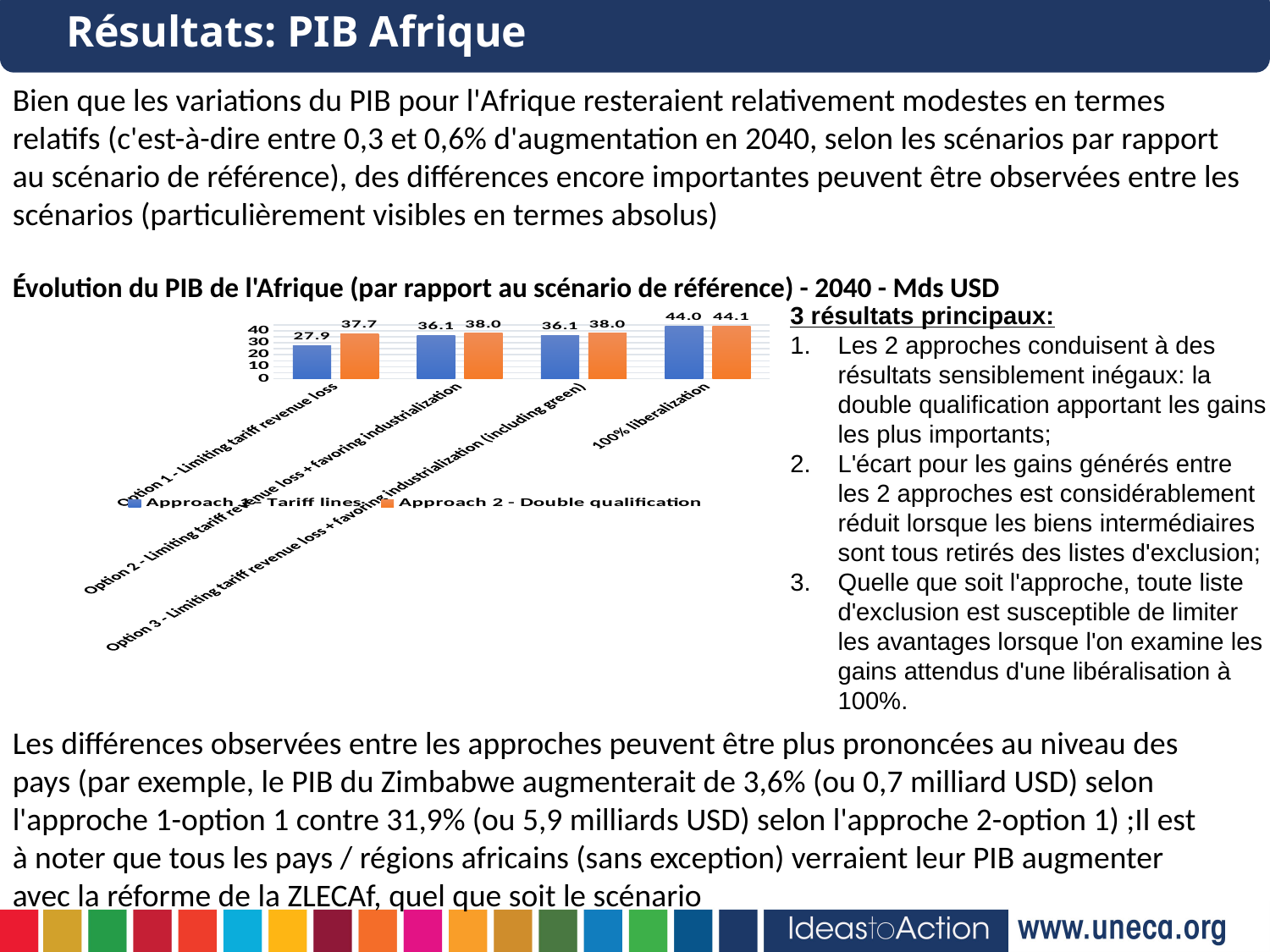
What is the value for Approach 2 - Double qualification under Option 1 - Limiting tariff revenue loss? 37.7 Which category has the lowest value for Approach 1 - Tariff lines? Option 1 - Limiting tariff revenue loss Which category has the highest value for Approach 1 - Tariff lines? 100% liberalization Under Option 3, which is larger: Approach 1 - Tariff lines or Approach 2 - Double qualification? Approach 2 - Double qualification What type of chart is shown on the slide? bar chart What is the value for Approach 1 - Tariff lines under Option 1 - Limiting tariff revenue loss? 27.9 What is the value for Approach 1 - Tariff lines under 100% liberalization? 44.0 What is the title of the chart? Évolution du PIB de l'Afrique (par rapport au scénario de référence) - 2040 - Mds USD What is the value for Approach 2 - Double qualification under Option 2? 38.0 What is the difference between Approach 2 - Double qualification and Approach 1 - Tariff lines under Option 1 - Limiting tariff revenue loss? 9.8 How many series does the chart legend list? 2 How many categories (scenarios) are shown on the x axis of the chart? 4